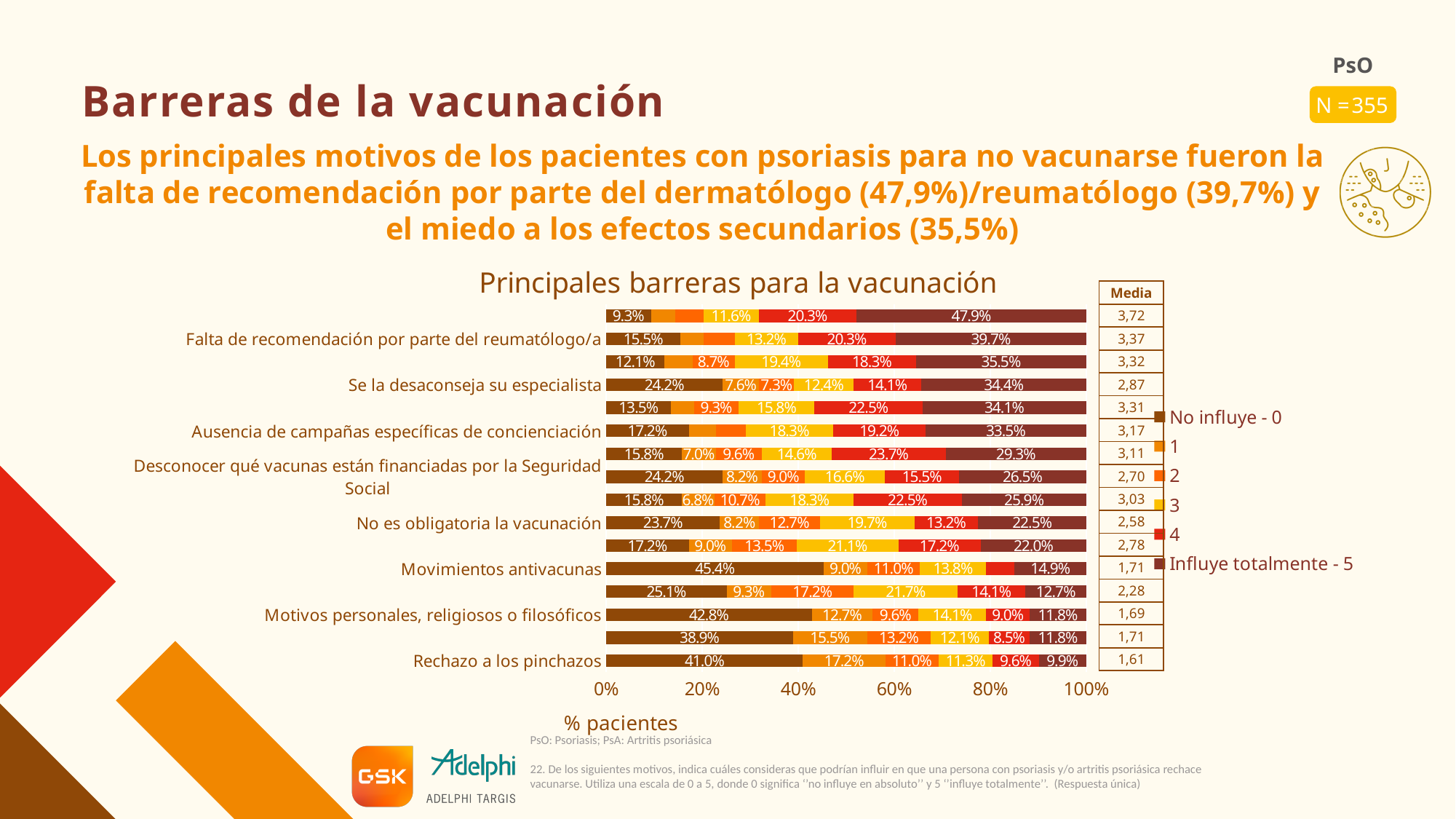
What is the 'Influye totalmente - 5' value for 'Rechazo a los pinchazos'? 9.9% What is the 'Influye totalmente - 5' value for 'Falta de recomendación por parte del reumatólogo/a'? 39.7% Which category has the highest 'No influye - 0' value? Movimientos antivacunas What is the label of the horizontal axis of the chart? % pacientes What is the difference in the 'Influye totalmente - 5' value between 'Falta de recomendación por parte del reumatólogo/a' and 'Rechazo a los pinchazos'? 29.8 percentage points What is the value of series '3' for 'No es obligatoria la vacunación'? 19.7% What kind of chart is shown under the title 'Principales barreras para la vacunación'? Stacked bar chart What is the 'No influye - 0' value for 'Movimientos antivacunas'? 45.4% What is the 'Media' value shown for 'Se la desaconseja su especialista'? 2,87 How many series does the legend of the chart list? 6 Which has the larger 'Influye totalmente - 5' value: 'Se la desaconseja su especialista' or 'Ausencia de campañas específicas de concienciación'? Se la desaconseja su especialista What is the 'Media' value shown for 'Rechazo a los pinchazos'? 1,61